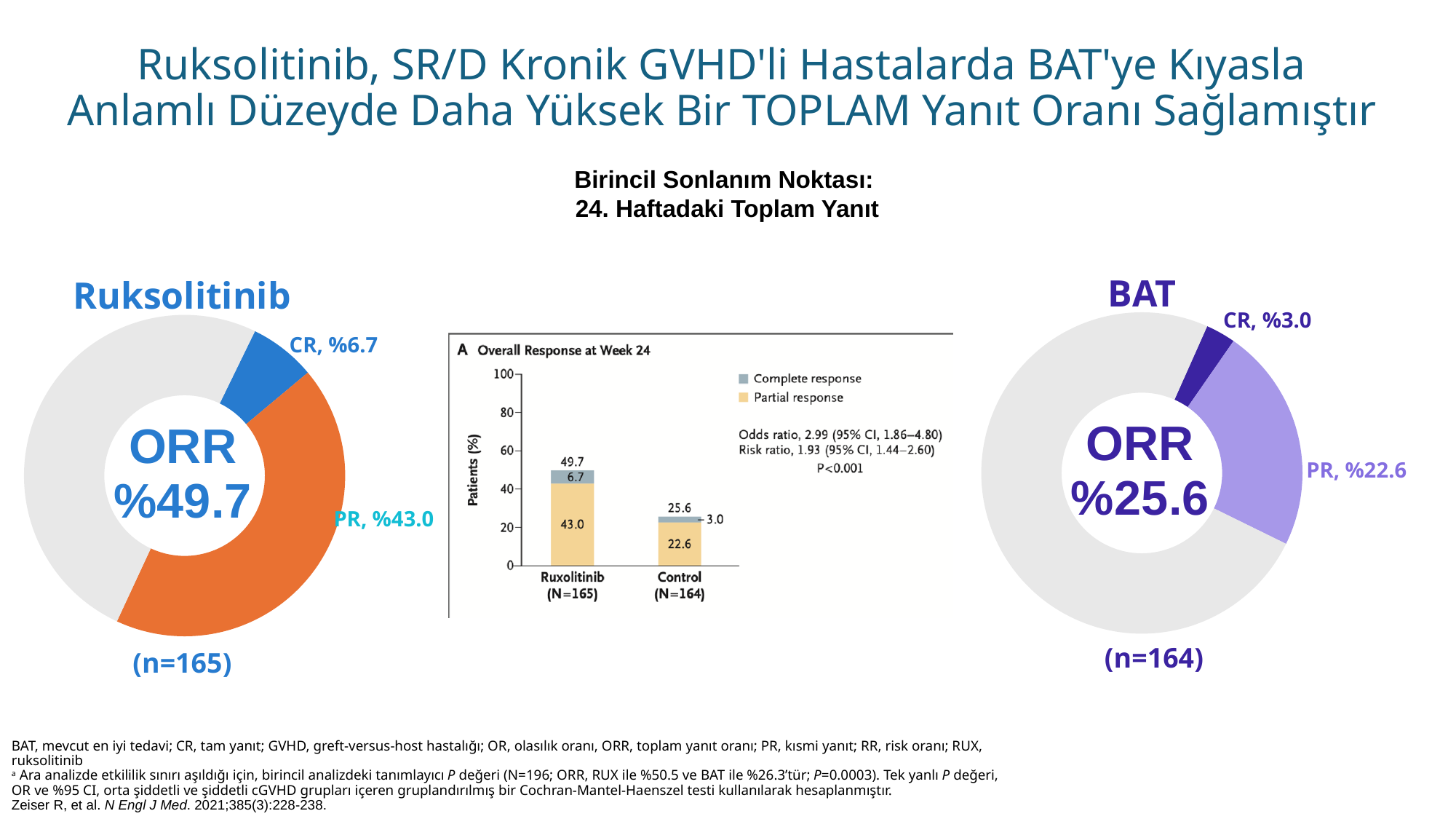
In the BAT donut chart, what is the value for PR? %22.6 In the Ruksolitinib donut chart, what is the value for CR? %6.7 In the center bar chart 'Overall Response at Week 24', what is the difference between the Ruxolitinib total and the Control total? 24.1 In the center bar chart 'Overall Response at Week 24', what is the total value of the Control bar? 25.6 What kind of chart is the center chart 'Overall Response at Week 24'? bar chart In the Ruksolitinib donut chart, what is the value for PR? %43.0 How many series does the legend of the center bar chart 'Overall Response at Week 24' list? 2 In the center bar chart 'Overall Response at Week 24', what is the total value of the Ruxolitinib bar? 49.7 In the center bar chart 'Overall Response at Week 24', is the Control bar total greater or less than 40? less In the BAT donut chart, what is the value for CR? %3.0 What is the ORR shown in the center of the BAT donut chart? %25.6 In the center bar chart 'Overall Response at Week 24', which group has the higher partial response value, Ruxolitinib or Control? Ruxolitinib